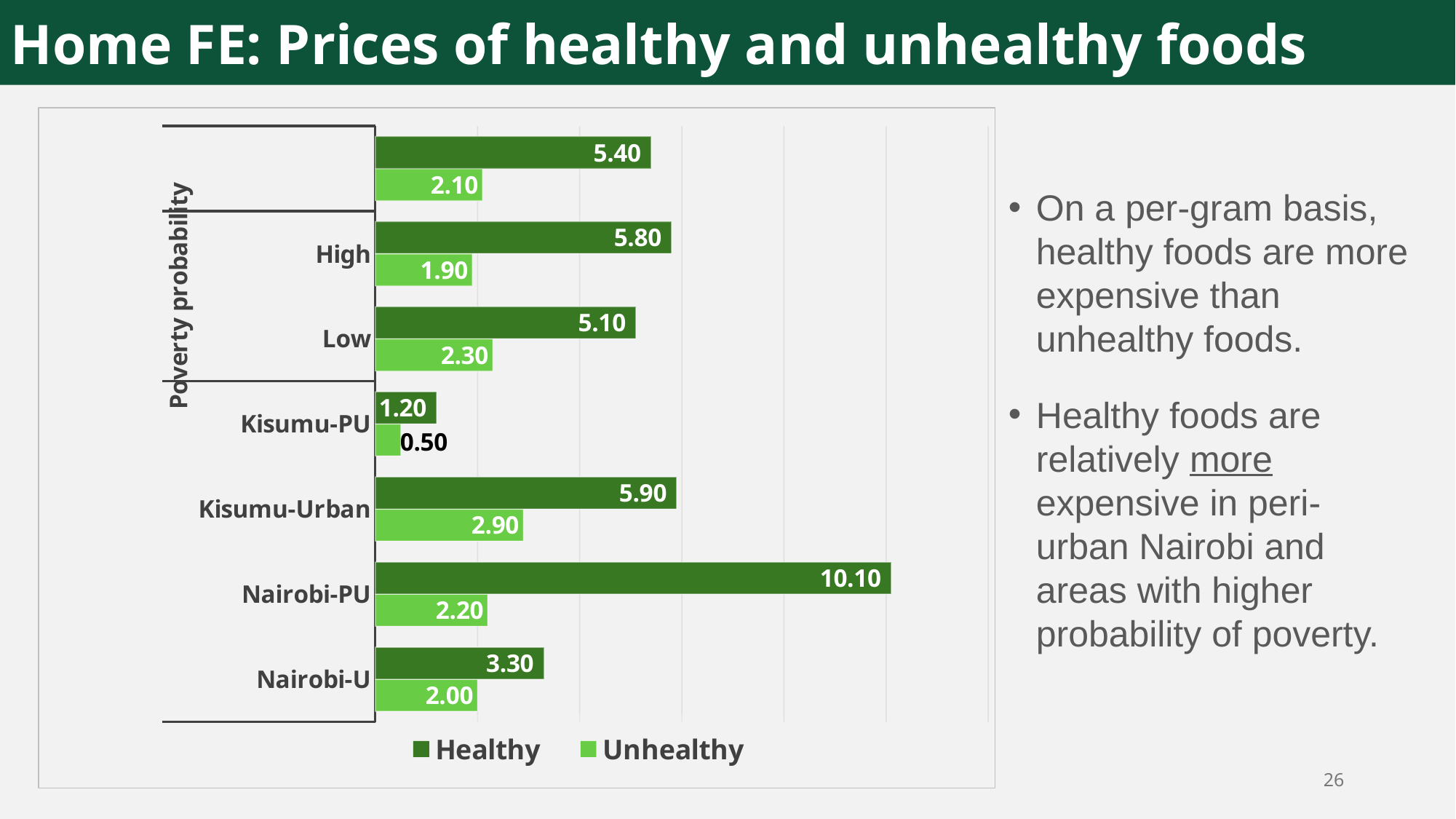
What is the Unhealthy value for Kisumu-PU? 0.50 Which is larger, the Healthy value for High or the Healthy value for Low? High Which category has the highest Unhealthy value? Kisumu-Urban Which series is shown in the darker green colour? Healthy What is the Unhealthy value for Kisumu-Urban? 2.90 What is the Healthy value for the Low poverty probability category? 5.10 What is the Healthy value for Nairobi-PU? 10.10 How many series does the legend list? 2 Which category has the lowest Unhealthy value? Kisumu-PU What is the difference between the Healthy and Unhealthy values for Nairobi-PU? 7.90 Which category has the highest Healthy value? Nairobi-PU What kind of chart is shown on the slide? Bar chart